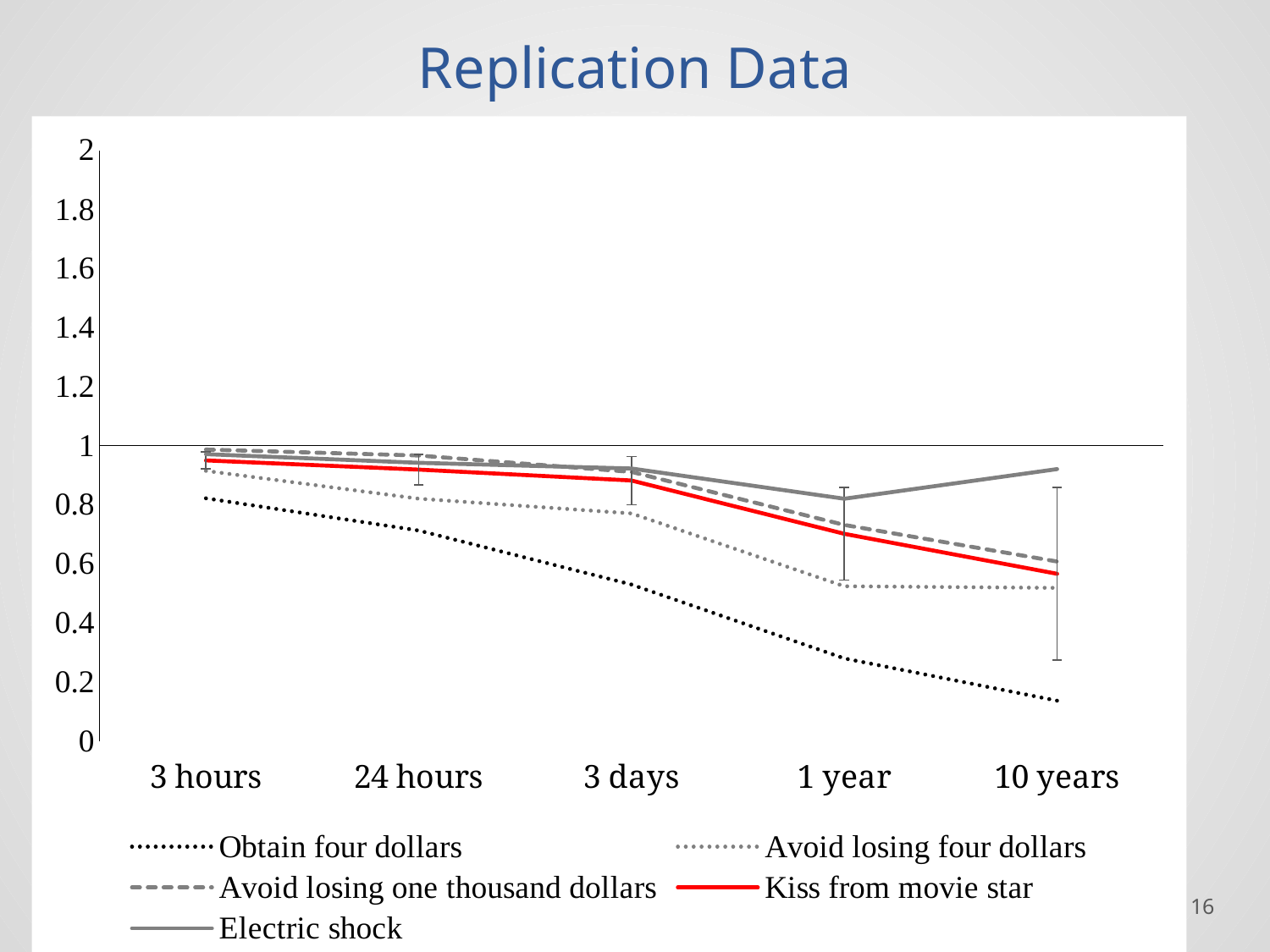
What kind of chart is shown on the slide? line chart At 1 year, which is larger: Electric shock or Obtain four dollars? Electric shock How many series does the legend list? 5 Which series has the highest value at 10 years? Electric shock Is the value for Avoid losing four dollars at 1 year greater or less than 0.6? less Which series has the lowest value at 10 years? Obtain four dollars How many time-delay categories are shown on the x axis? 5 Does the Obtain four dollars line rise or fall from 3 hours to 10 years? falls Is the value for Obtain four dollars at 10 years greater or less than 0.2? less What is the title of the chart? Replication Data Is the value for Electric shock at 10 years greater or less than 0.8? greater